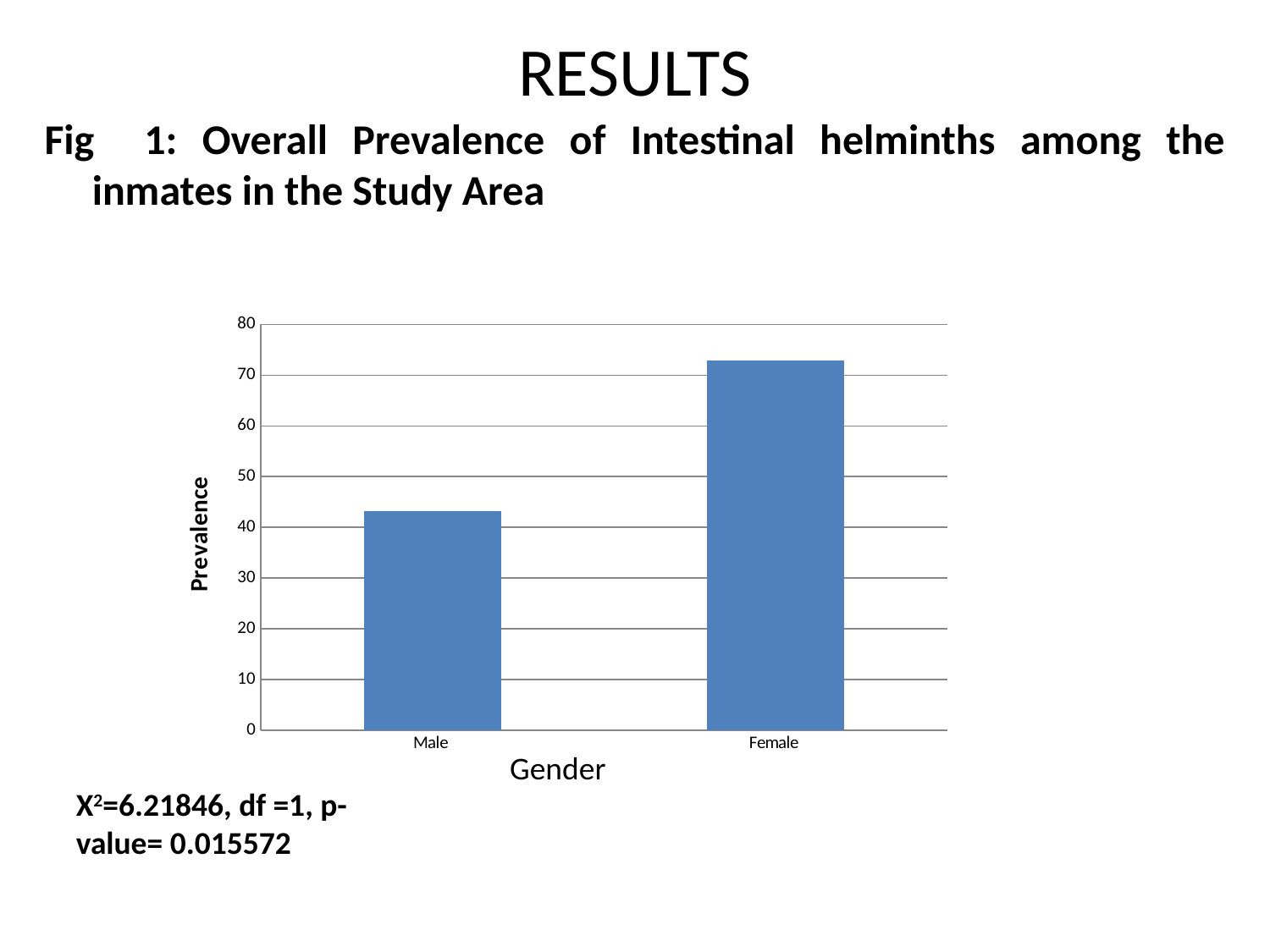
Which gender has the lowest prevalence in the chart? Male What is the label on the horizontal axis of the chart? Gender What kind of chart is shown on the slide? bar chart Which gender has the highest prevalence in the chart? Female Is the prevalence value for Female greater or less than 70? greater Which is larger, the prevalence for Male or for Female? Female Is the prevalence value for Female greater or less than 80? less Is the prevalence value for Male greater or less than 40? greater What is the label on the vertical axis of the chart? Prevalence Do the bar values rise or fall moving from Male to Female along the x axis? rise How many categories are plotted on the x axis of the chart? 2